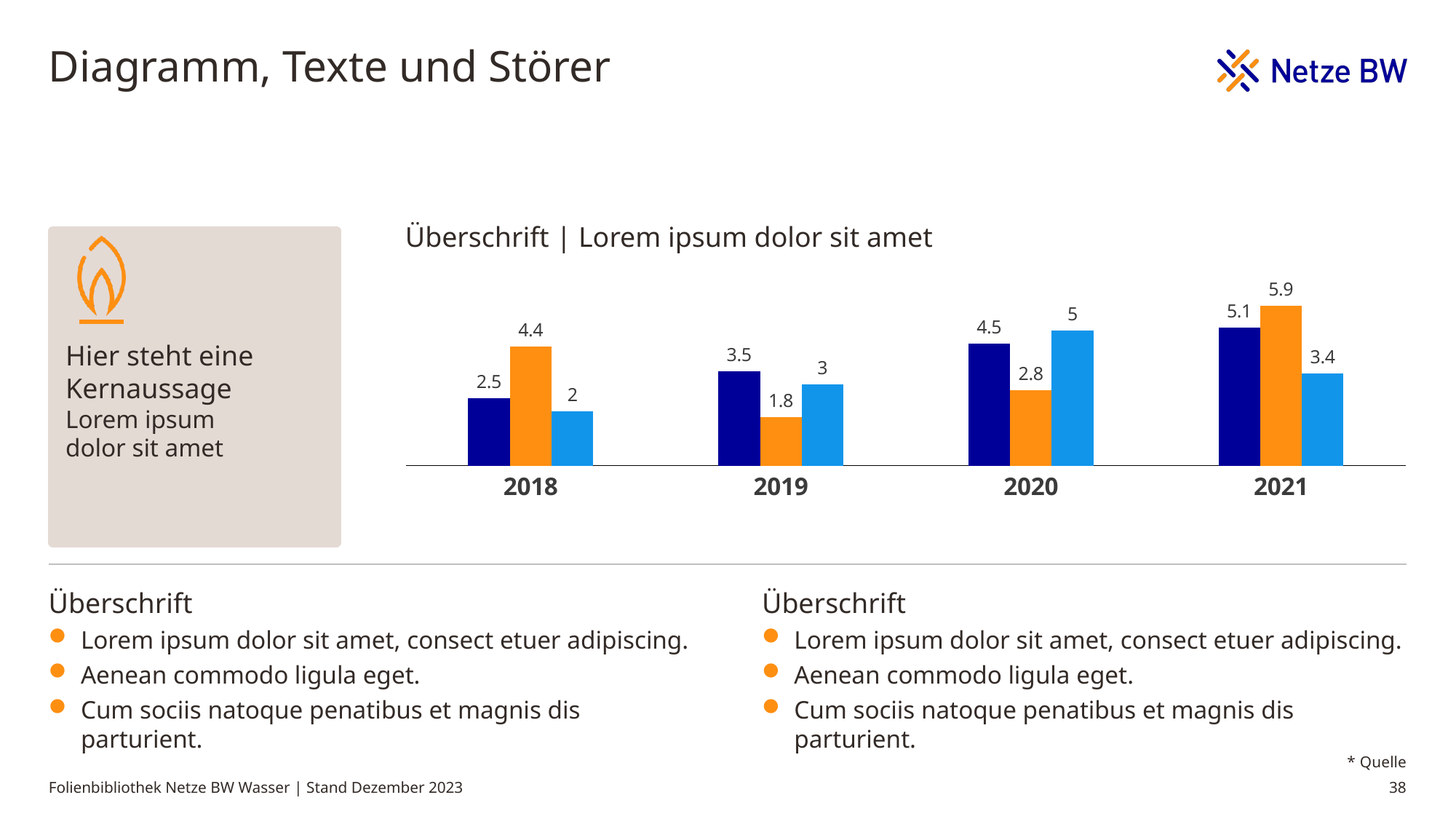
In which year is the dark blue bar highest? 2021 What is the value of the light blue bar for 2020? 5 What is the difference between the orange bar and the dark blue bar in 2018? 1.9 What is the value of the dark blue bar for 2018? 2.5 What is the value of the orange bar for 2019? 1.8 In which year is the orange bar lowest? 2019 What kind of chart is shown on the slide? bar chart Do the dark blue bars rise or fall from 2018 to 2021? rise What is the value of the orange bar for 2021? 5.9 How many bars are shown for each year in the chart? 3 How many years are shown on the x axis of the chart? 4 Which is larger in 2020: the dark blue bar or the light blue bar? the light blue bar